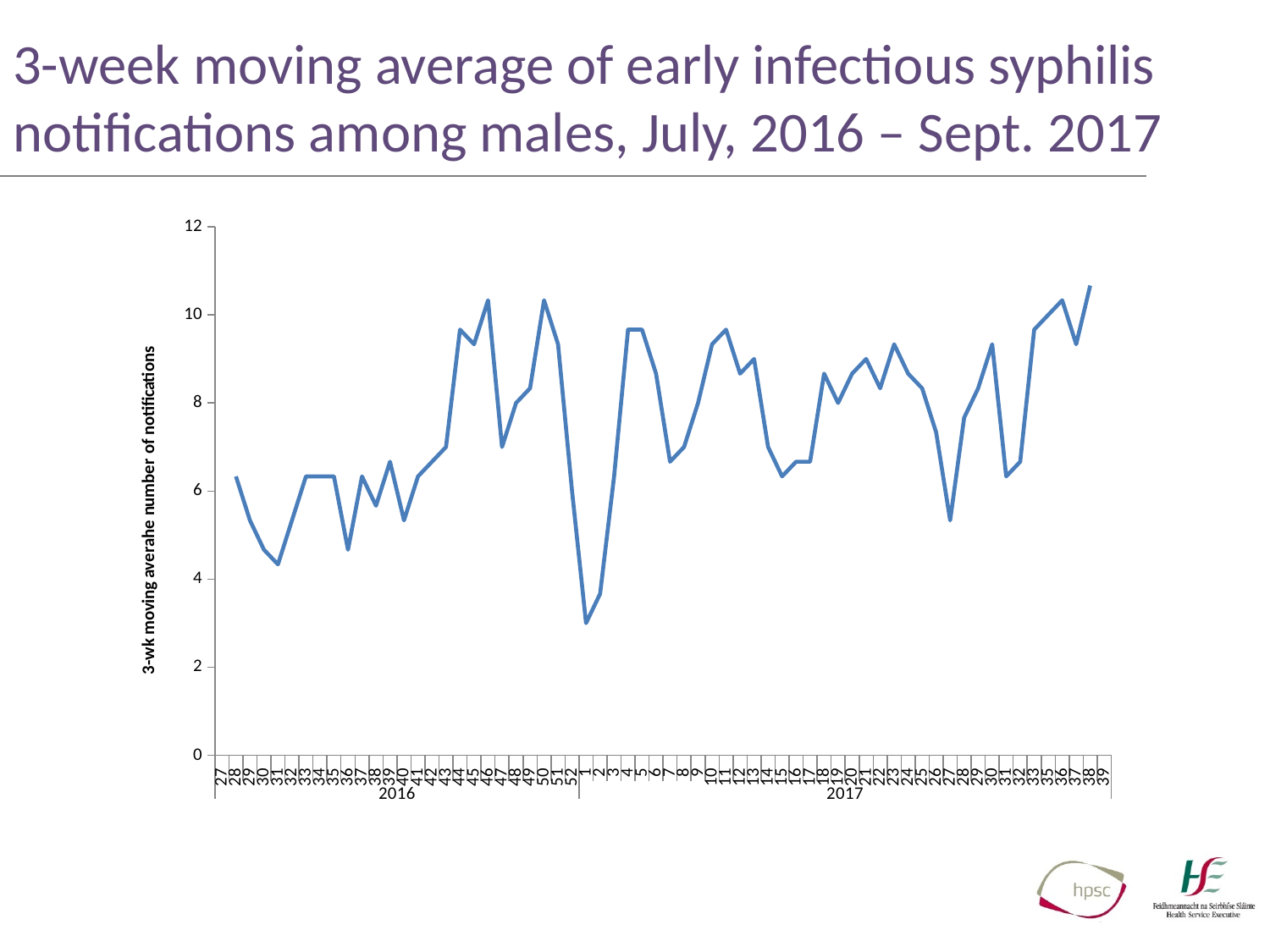
How many data series are plotted on the chart? 1 Which two years are labelled on the x axis of the chart? 2016 and 2017 What type of chart is shown on the slide? line chart Is the value for week 31 of 2016 greater or less than 6? less Is the value for week 27 of 2017 greater or less than 6? less Which has the larger value, week 31 of 2016 or week 5 of 2017? week 5 of 2017 In which week is the 3-week moving average at its lowest point? week 1 of 2017 Is the value for week 5 of 2017 greater or less than 8? greater Which has the larger value, week 46 of 2016 or week 1 of 2017? week 46 of 2016 Do the values rise or fall between week 50 of 2016 and week 1 of 2017? fall